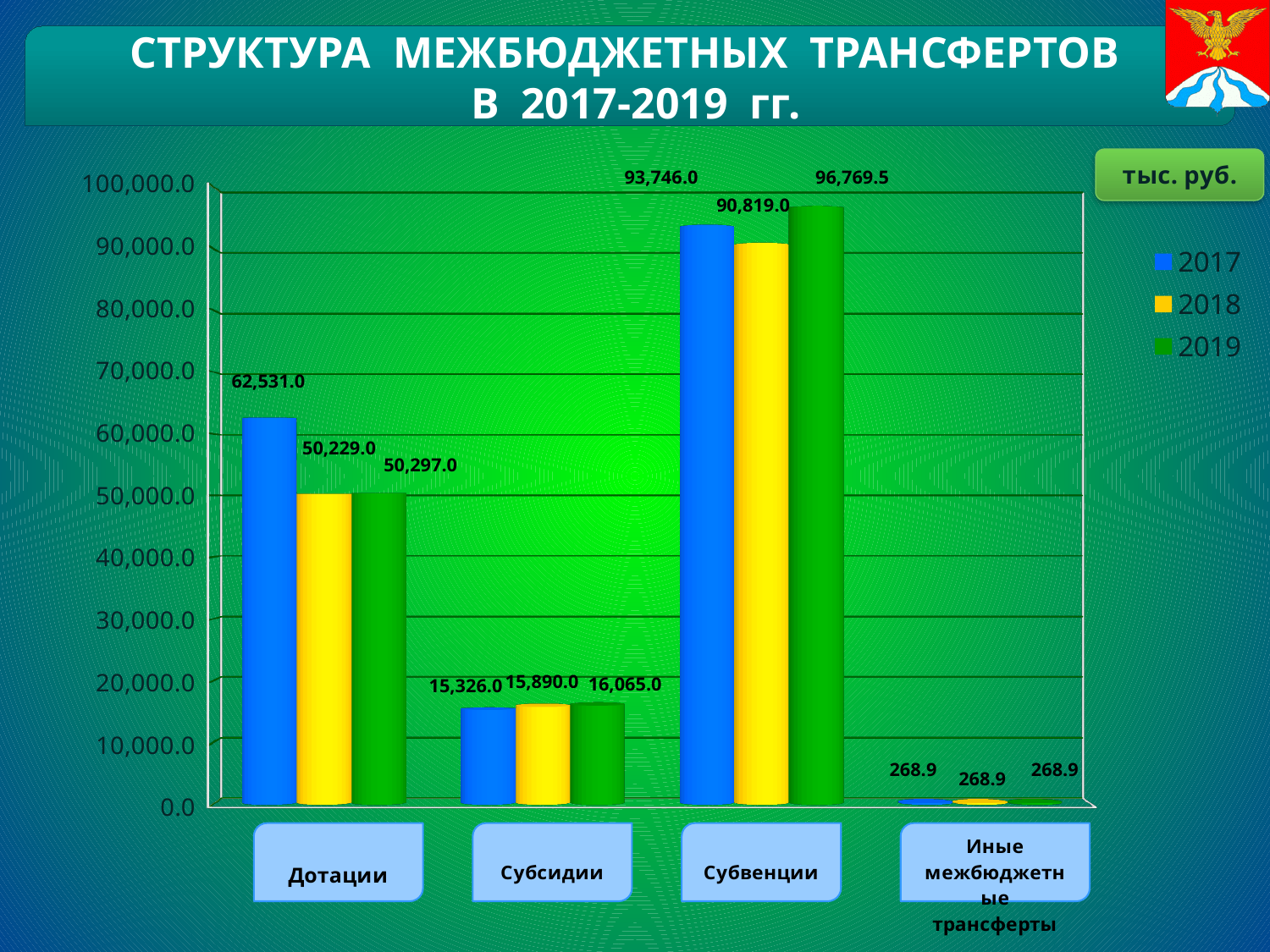
What kind of chart is shown on the slide? bar chart Is the value for Субсидии in 2019 greater or less than 20,000.0? less How many series does the legend list? 3 How many categories are shown on the x axis? 4 Which category has the highest value in 2019? Субвенции What is the value for Иные межбюджетные трансферты in 2017? 268.9 Which is larger for Субвенции: the 2017 value or the 2018 value? 2017 Which category has the lowest value in 2018? Иные межбюджетные трансферты What is the value for Субвенции in 2019? 96,769.5 What is the value for Субсидии in 2018? 15,890.0 What is the difference between the 2017 and 2018 values for Дотации? 12,302.0 What is the value for Дотации in 2017? 62,531.0